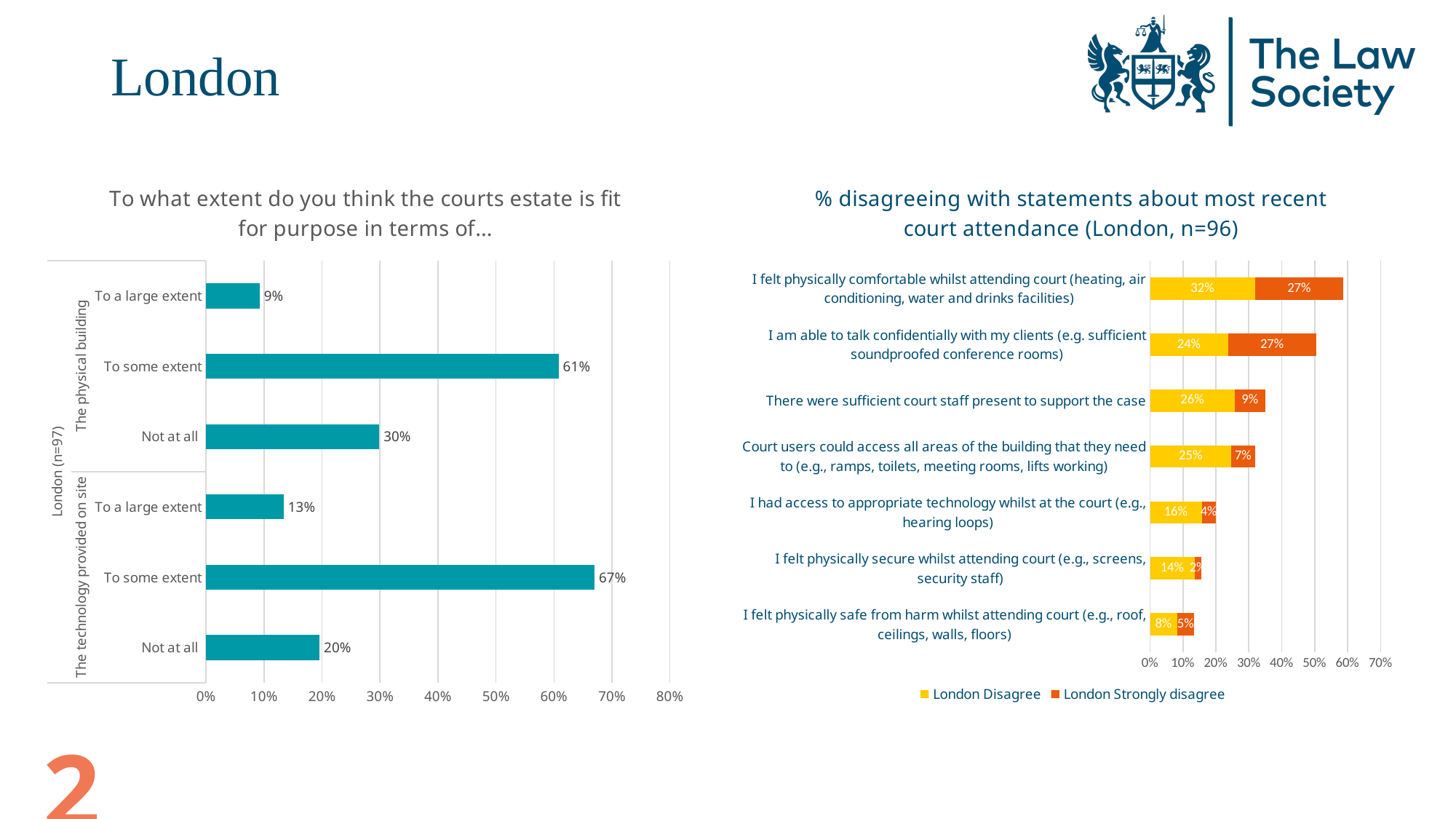
How many series does the legend of the right chart '% disagreeing with statements about most recent court attendance' list? 2 In the left chart 'To what extent do you think the courts estate is fit for purpose in terms of...', which is larger: 'To a large extent' for the physical building or 'To a large extent' for the technology provided on site? The technology provided on site (13%) In the right chart '% disagreeing with statements about most recent court attendance', what percentage strongly disagreed that they felt physically comfortable whilst attending court? 27% In the right chart '% disagreeing with statements about most recent court attendance', which statement has the lowest 'London Disagree' value? I felt physically safe from harm whilst attending court (8%) How many statements are shown in the right chart '% disagreeing with statements about most recent court attendance'? 7 What type of chart is the left chart 'To what extent do you think the courts estate is fit for purpose in terms of...'? Bar chart In the left chart 'To what extent do you think the courts estate is fit for purpose in terms of...', which response has the highest value across both groups? To some extent (the technology provided on site), 67% In the right chart '% disagreeing with statements about most recent court attendance', what colour represents 'London Strongly disagree'? Orange In the left chart 'To what extent do you think the courts estate is fit for purpose in terms of...', what is the difference between 'Not at all' for the physical building and 'Not at all' for the technology provided on site? 10 percentage points In the left chart 'To what extent do you think the courts estate is fit for purpose in terms of...', what percentage said 'Not at all' for the technology provided on site? 20% In the right chart '% disagreeing with statements about most recent court attendance', what is the total percentage disagreeing (Disagree plus Strongly disagree) with 'I am able to talk confidentially with my clients'? 51% In the left chart 'To what extent do you think the courts estate is fit for purpose in terms of...', what percentage said 'To some extent' for the physical building? 61%